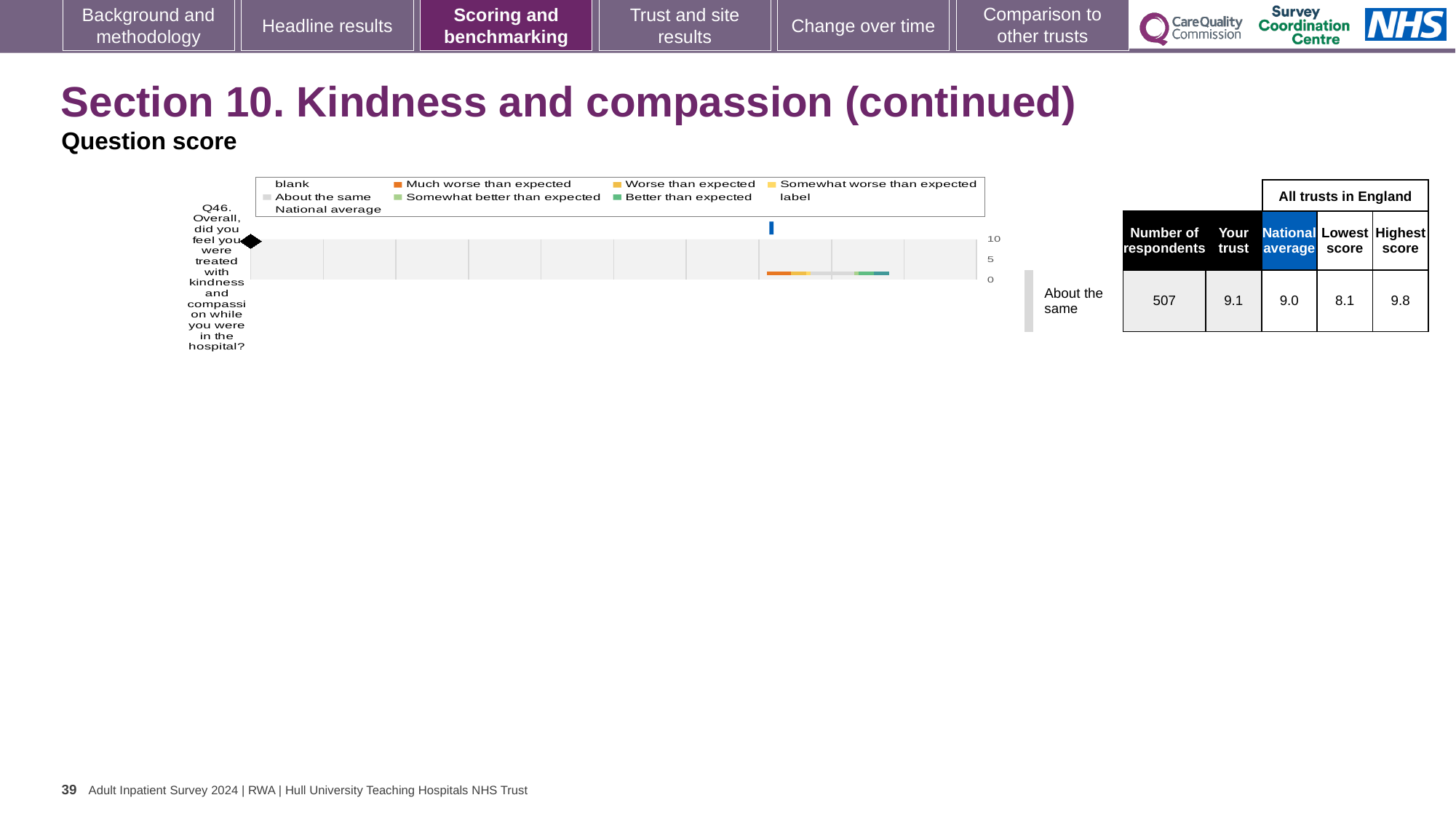
Which is larger for Q46, the 'Your trust' score or the national average? Your trust What is the highest score among all trusts in England for Q46? 9.8 Is the 'Your trust' score for Q46 greater or less than 5 on the chart's axis? greater What is the lowest score among all trusts in England for Q46? 8.1 What is the highest value shown on the chart's numeric axis? 10 Which benchmark band is the trust's Q46 score placed in, according to the label next to the chart? About the same What is the national average score for Q46? 9.0 What is the difference between the highest and lowest scores among all trusts in England for Q46? 1.7 What is the 'Your trust' score for Q46? 9.1 What kind of chart is shown on the slide for Q46? bar chart How many respondents answered Q46? 507 How many questions (categories) are plotted on the chart? 1